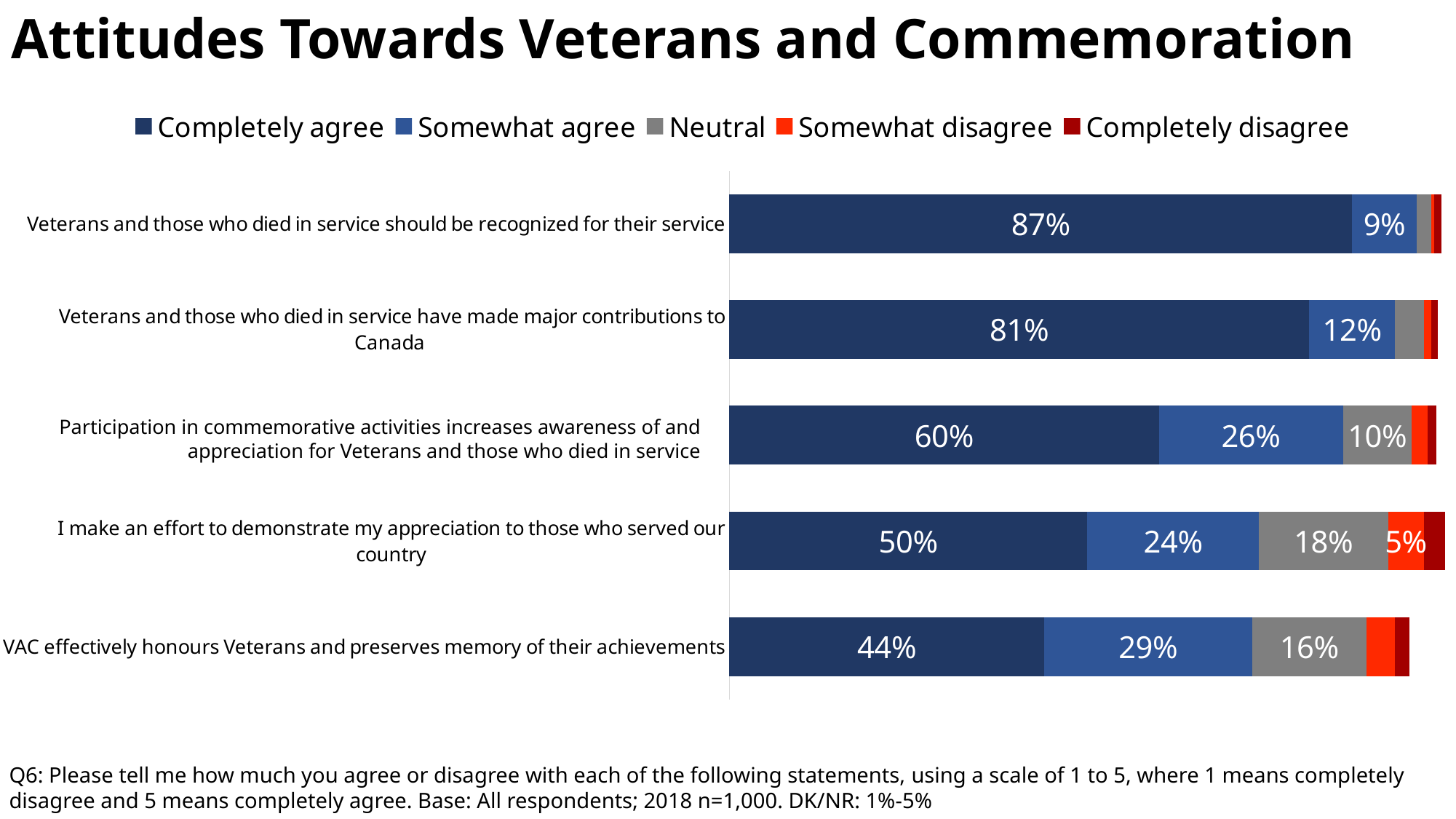
What type of chart is shown on the slide? Stacked bar chart What is the Neutral value for the statement 'Participation in commemorative activities increases awareness of and appreciation for Veterans and those who died in service'? 10% What percentage somewhat agree that Veterans and those who died in service have made major contributions to Canada? 12% What is the Somewhat agree value for 'VAC effectively honours Veterans and preserves memory of their achievements'? 29% Which statement has the highest Completely agree percentage? Veterans and those who died in service should be recognized for their service What percentage completely agree that Veterans and those who died in service should be recognized for their service? 87% Which has a larger Neutral share: 'I make an effort to demonstrate my appreciation to those who served our country' or 'VAC effectively honours Veterans and preserves memory of their achievements'? I make an effort to demonstrate my appreciation to those who served our country How many statements are shown in the chart? 5 What percentage somewhat disagree with the statement 'I make an effort to demonstrate my appreciation to those who served our country'? 5% How many series does the legend list? 5 Which statement has the lowest Completely agree percentage? VAC effectively honours Veterans and preserves memory of their achievements What is the difference between the Completely agree percentages for 'Veterans and those who died in service should be recognized for their service' and 'Veterans and those who died in service have made major contributions to Canada'? 6%